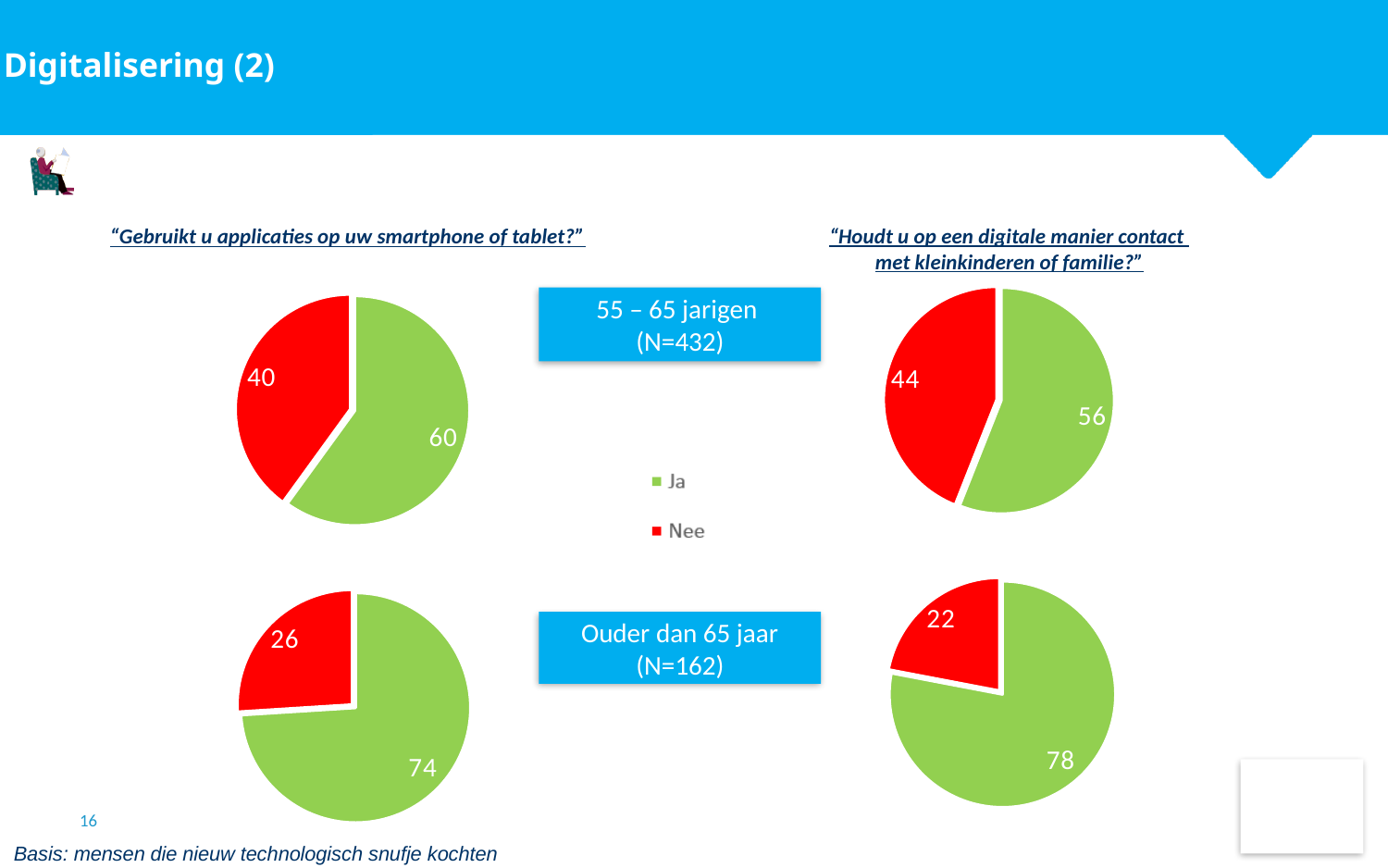
In the bottom-right pie chart (digitale manier contact, Ouder dan 65 jaar), what is the value for Ja? 78 In the bottom-left pie chart (applicaties op smartphone of tablet, Ouder dan 65 jaar), what is the value for Ja? 74 Which colour represents Nee in the pie charts? Red How many entries does the legend list? 2 In the top-right pie chart (digitale manier contact, 55 – 65 jarigen), which slice is the largest? Ja What type of chart is used on this slide? Pie chart Is the Ja value larger in the top-left pie chart (55 – 65 jarigen) or in the bottom-left pie chart (Ouder dan 65 jaar) for applicaties op smartphone of tablet? Bottom-left (Ouder dan 65 jaar) In the bottom-right pie chart (digitale manier contact, Ouder dan 65 jaar), which slice is the smallest? Nee In the top-right pie chart (digitale manier contact, 55 – 65 jarigen), what is the value for Nee? 44 In the top-left pie chart (applicaties op smartphone of tablet, 55 – 65 jarigen), what is the value for Nee? 40 In the top-left pie chart (applicaties op smartphone of tablet, 55 – 65 jarigen), what is the value for Ja? 60 In the bottom-left pie chart (applicaties op smartphone of tablet, Ouder dan 65 jaar), what is the difference between Ja and Nee? 48